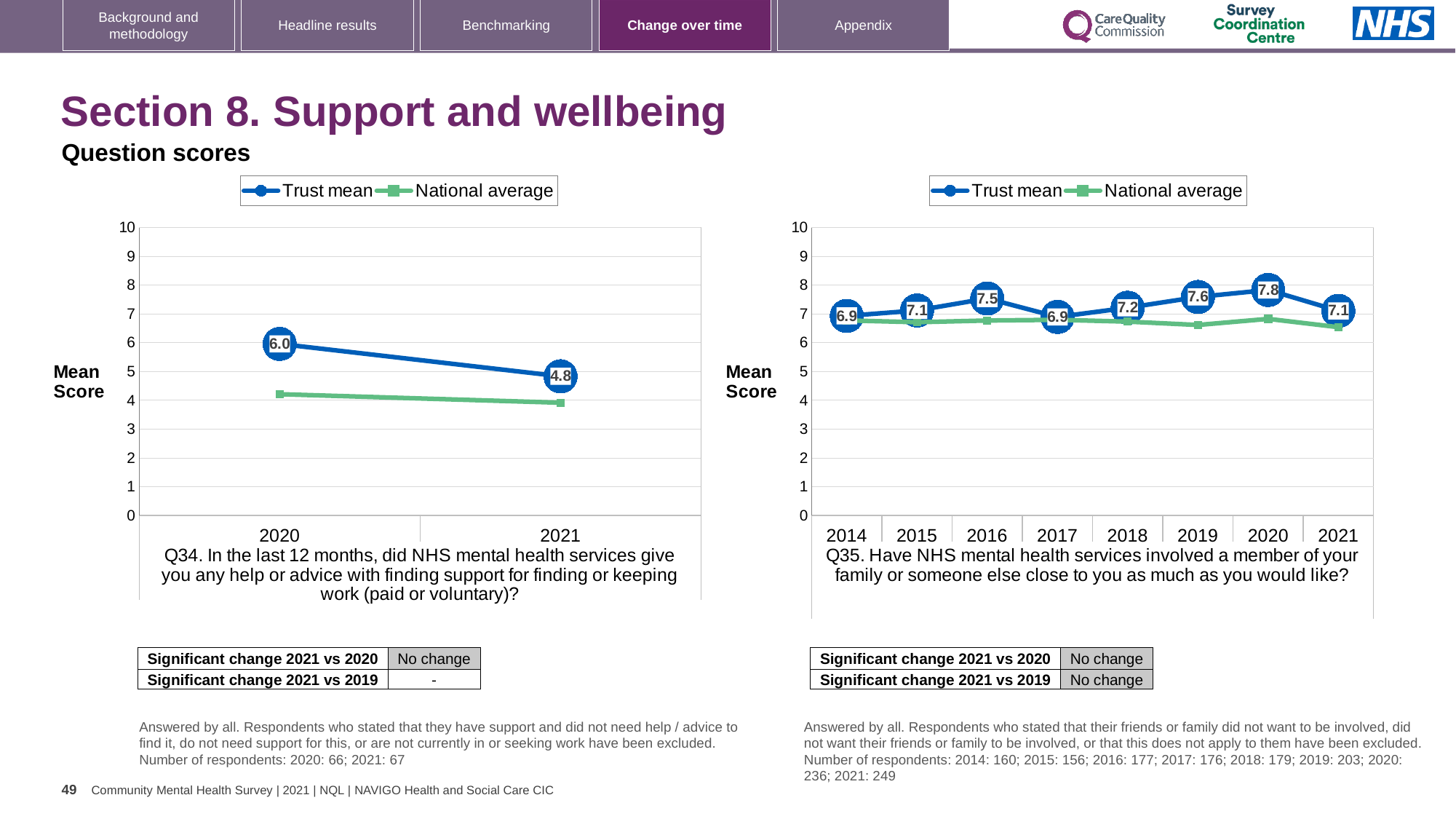
In the left chart (Q34), is the National average for 2020 greater or less than 5? less In the right chart (Q35), which year has the highest Trust mean? 2020 In the right chart (Q35), which is larger, the Trust mean in 2016 or in 2017? 2016 In the left chart (Q34), what is the Trust mean for 2020? 6.0 In the right chart (Q35), how many years are plotted on the x axis? 8 In the left chart (Q34), by how much did the Trust mean fall from 2020 to 2021? 1.2 In the left chart (Q34), does the Trust mean rise or fall from 2020 to 2021? fall In the right chart (Q35), how many series does the legend list? 2 In the left chart (Q34), what is the Trust mean for 2021? 4.8 In the right chart (Q35), what is the difference between the Trust mean in 2020 and in 2021? 0.7 What type of chart is used on the left of the slide? line chart In the right chart (Q35), what is the Trust mean for 2020? 7.8